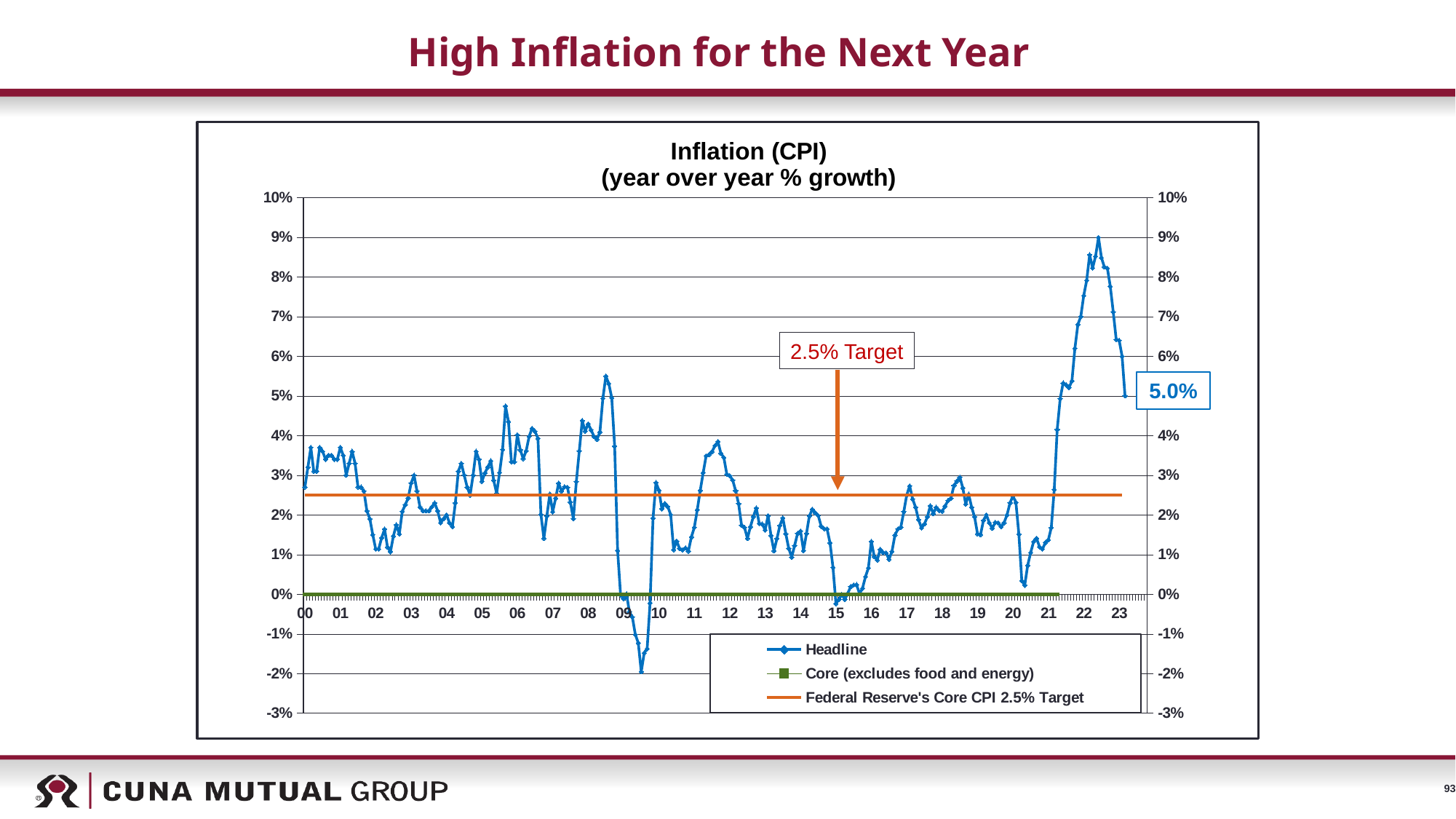
What is the most recent Headline inflation value labeled on the chart? 5.0% What is the Federal Reserve's Core CPI target shown on the chart? 2.5% What is the full legend label of the series shown with green square markers? Core (excludes food and energy) What kind of chart is shown on the slide? line chart Is the Headline value at the start of 2000 greater or less than 2%? greater Is the peak value of the Headline series in 2022 greater or less than 8%? greater Which peak of the Headline series is higher, the one in 2008 or the one in 2022? 2022 Is the lowest value of the Headline series (around 2009) greater or less than -1%? less How many series does the legend list? 3 From its 2022 peak to 2023, does the Headline series rise or fall? fall What is the title of the chart? Inflation (CPI) (year over year % growth)